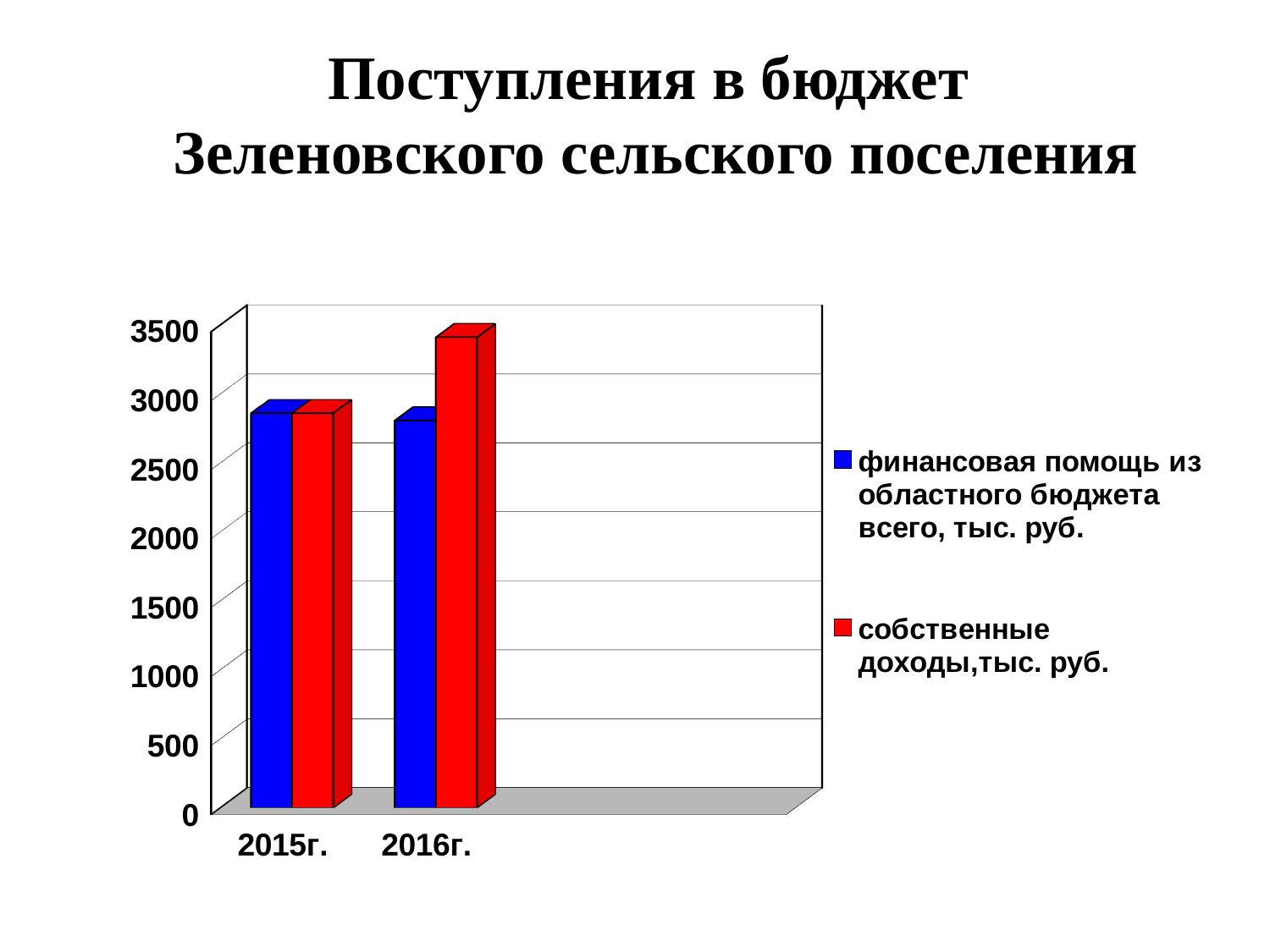
Is the value for собственные доходы in 2016г. greater or less than 3000? greater What is the title of the slide containing the chart? Поступления в бюджет Зеленовского сельского поселения How many years (categories) are shown on the x axis of the chart? 2 Which bar is the highest in the chart? собственные доходы in 2016г. Is the value for финансовая помощь из областного бюджета in 2015г. greater or less than 3000? less Which series is shown in red in the chart? собственные доходы,тыс. руб. What kind of chart is shown on the slide? bar chart How many series does the chart's legend list? 2 Do the values for собственные доходы rise or fall from 2015г. to 2016г.? rise Is the value for финансовая помощь из областного бюджета in 2016г. greater or less than 3000? less In 2016г., which is larger: финансовая помощь из областного бюджета or собственные доходы? собственные доходы